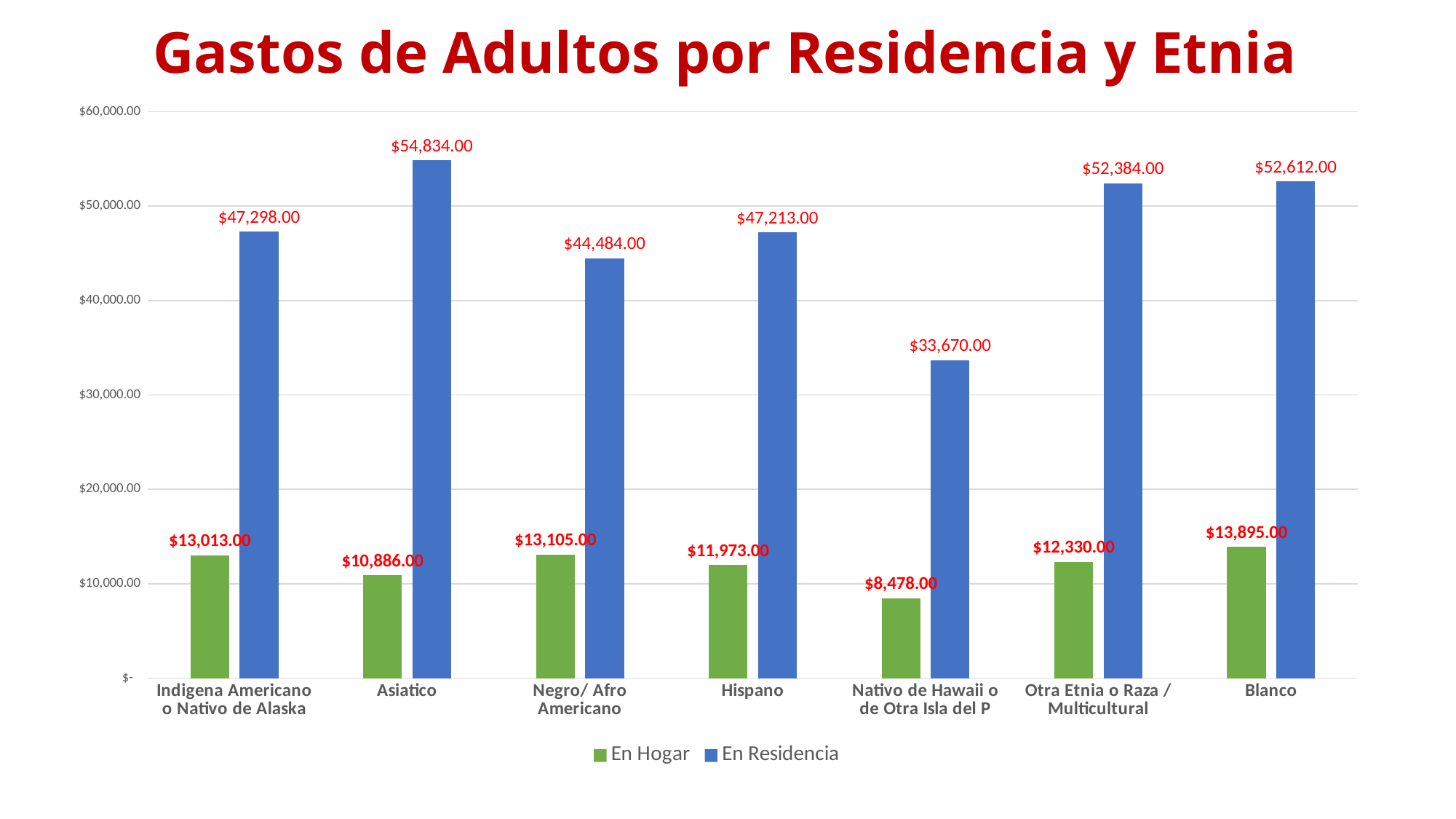
What is the En Hogar value for Nativo de Hawaii o de Otra Isla del P? $8,478.00 Which category has the highest En Residencia value? Asiatico How many categories are shown on the x axis? 7 Is the En Residencia value for Nativo de Hawaii o de Otra Isla del P greater or less than $40,000.00? less What is the En Hogar value for Blanco? $13,895.00 Which is larger: the En Residencia value for Negro/ Afro Americano or for Hispano? Hispano Which category has the lowest En Hogar value? Nativo de Hawaii o de Otra Isla del P Which category has the lowest En Residencia value? Nativo de Hawaii o de Otra Isla del P What is the difference between the En Residencia and En Hogar values for Asiatico? $43,948.00 What kind of chart is shown on the slide? bar chart What is the En Residencia value for Asiatico? $54,834.00 How many series does the legend list? 2